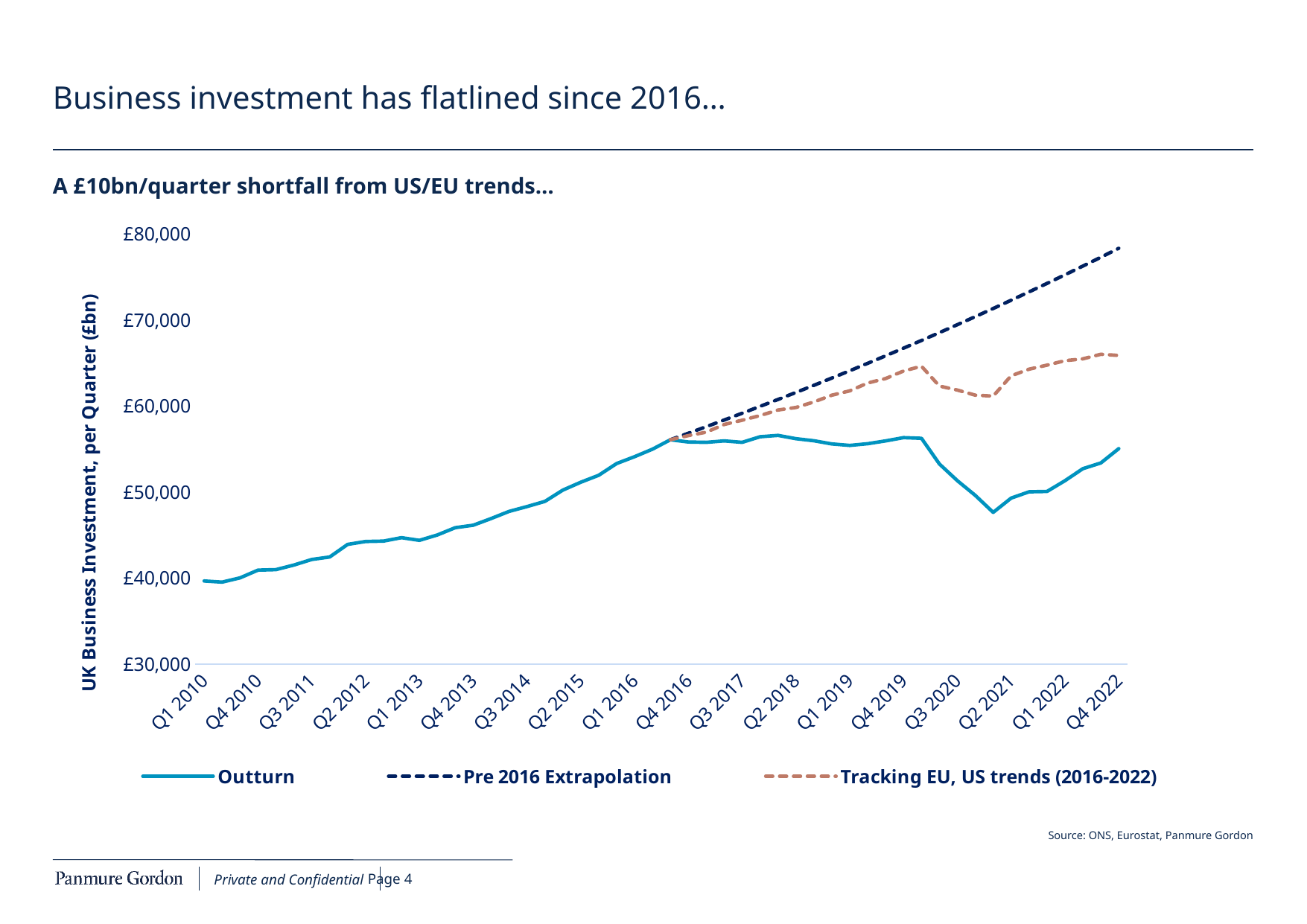
Is the Outturn value at Q4 2022 greater or less than £60,000? less What is the title of the chart? A £10bn/quarter shortfall from US/EU trends... What kind of chart is shown on the slide? Line chart Is the Tracking EU, US trends (2016-2022) value at Q4 2022 greater or less than £60,000? greater At Q4 2022, which is larger: the Outturn value or the Tracking EU, US trends (2016-2022) value? Tracking EU, US trends (2016-2022) Which series has the highest value at Q4 2022? Pre 2016 Extrapolation Does the Pre 2016 Extrapolation series rise or fall from Q4 2016 to Q4 2022? Rise Which series has the lowest value at Q4 2022? Outturn How many series does the legend list? 3 Is the Pre 2016 Extrapolation value at Q4 2022 greater or less than £70,000? greater What is the label on the vertical axis? UK Business Investment, per Quarter (£bn)